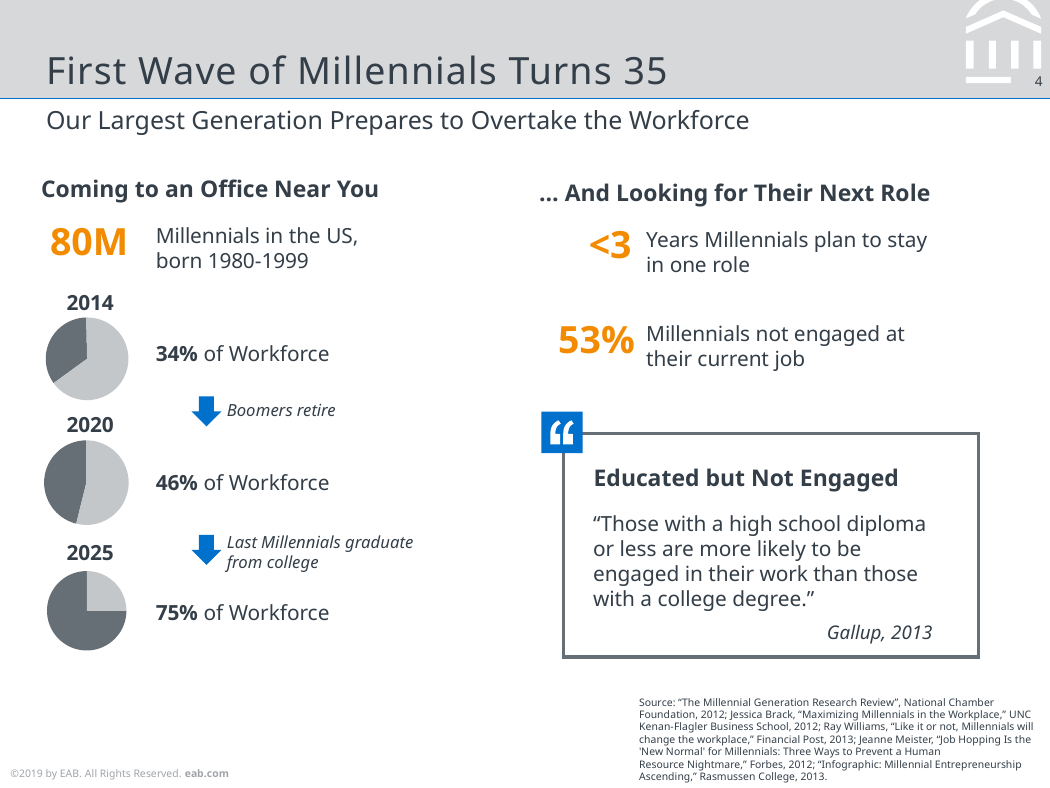
By how many percentage points does the Millennial share of the workforce grow from the 2014 pie chart to the 2020 pie chart? 12 percentage points What event is labelled between the 2014 and 2020 pie charts as driving the change in Millennial workforce share? Boomers retire How many pie charts are shown on the slide? 3 What kind of chart is used to show the Millennial share of the workforce for 2014, 2020 and 2025? Pie chart In the 2020 pie chart, what percentage of the workforce do Millennials make up? 46% By how many percentage points does the Millennial share of the workforce grow from the 2020 pie chart to the 2025 pie chart? 29 percentage points Which year's pie chart shows the smallest Millennial share of the workforce? 2014 Which year's pie chart shows the largest Millennial share of the workforce? 2025 Is the Millennial share of the workforce larger in the 2020 pie chart or the 2014 pie chart? 2020 Does the Millennial share of the workforce rise or fall across the pie charts from 2014 to 2025? Rise In the 2014 pie chart, what percentage of the workforce do Millennials make up? 34% In the 2025 pie chart, what percentage of the workforce do Millennials make up? 75%